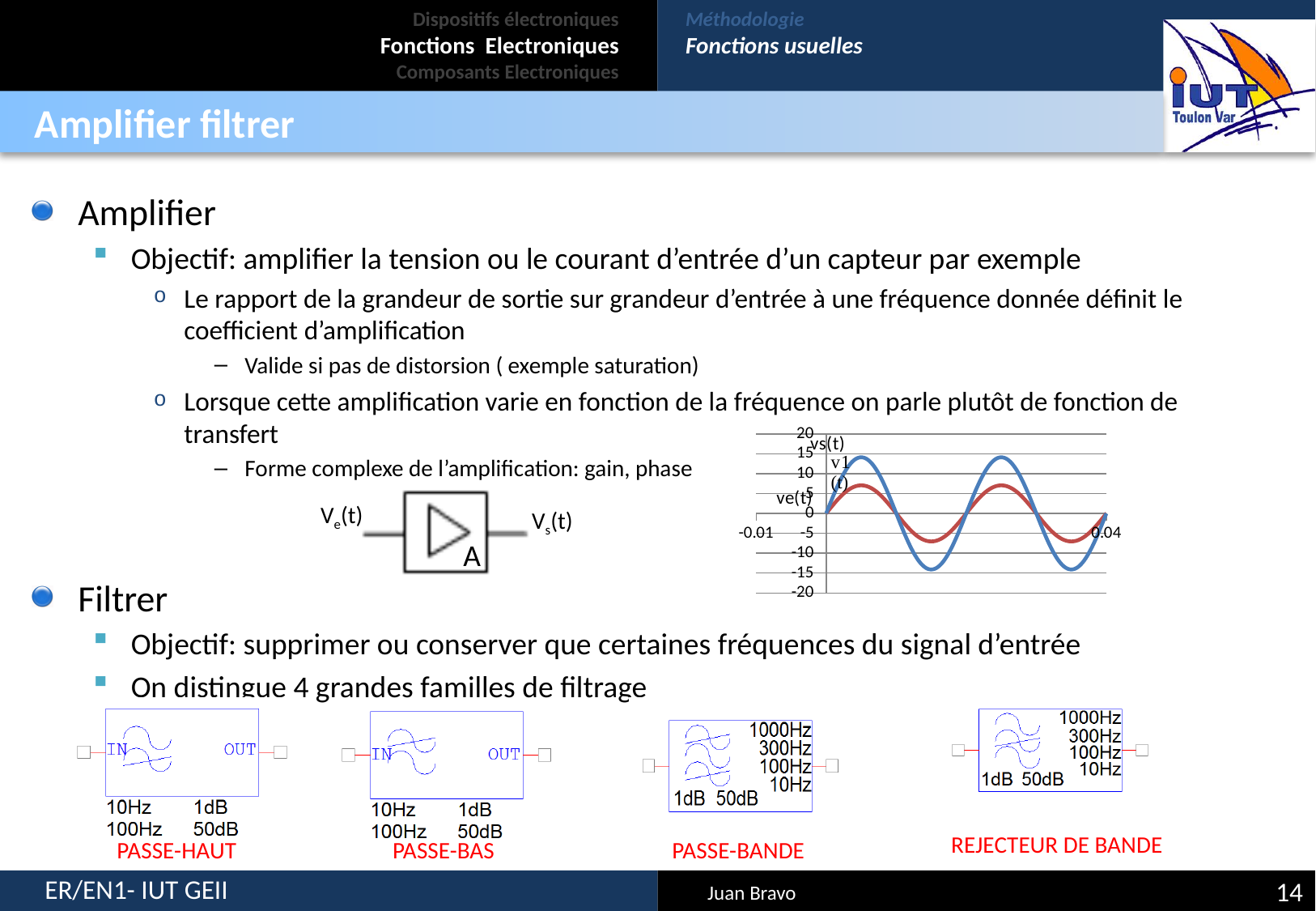
On the chart next to the amplifier diagram, is the minimum value of the red curve ve(t) greater or less than -10? greater What is the highest value shown on the vertical axis of the chart next to the amplifier diagram? 20 On the chart next to the amplifier diagram, which curve is drawn in blue, vs(t) or ve(t)? vs(t) On the chart next to the amplifier diagram, which curve reaches the higher peak value, vs(t) or ve(t)? vs(t) On the chart next to the amplifier diagram, is the peak value of the red curve ve(t) greater or less than 10? less How many curves are plotted on the chart next to the amplifier diagram? 2 What kind of chart is shown on the right side of the slide, next to the amplifier diagram? line chart On the chart next to the amplifier diagram, is the minimum value of the blue curve vs(t) greater or less than -10? less What is the lowest value shown on the vertical axis of the chart next to the amplifier diagram? -20